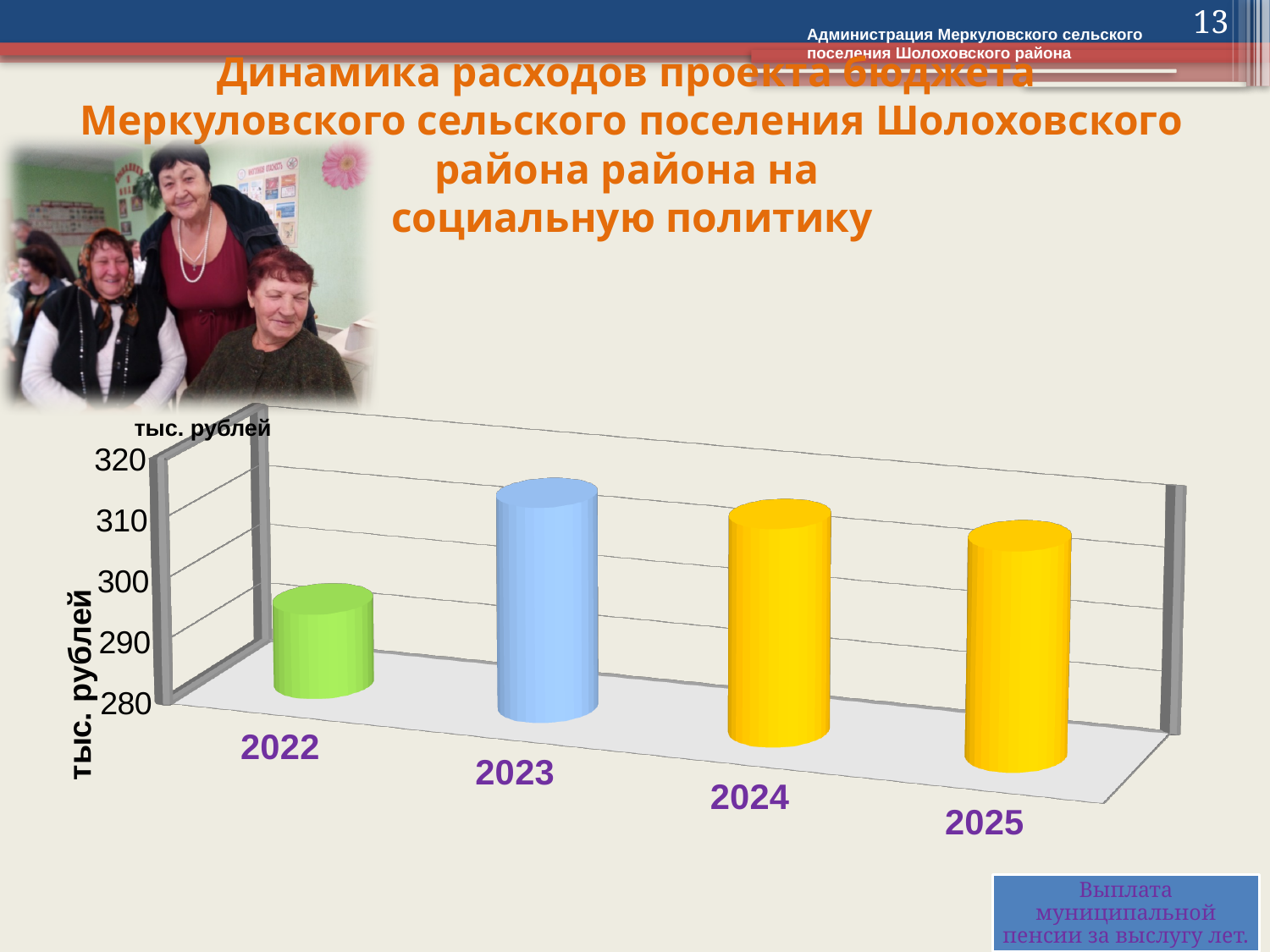
Which is larger, the value for 2022 or the value for 2023? 2023 How many years are shown on the x axis of the chart? 4 Which year has the lowest value in the chart? 2022 Is the value for 2022 greater or less than 300? less Is the value for 2024 greater or less than 300? greater Is the value for 2023 greater or less than 300? greater What unit is shown on the vertical axis of the chart? тыс. рублей What colour is the bar for 2022? green What kind of chart is shown on the slide? bar chart